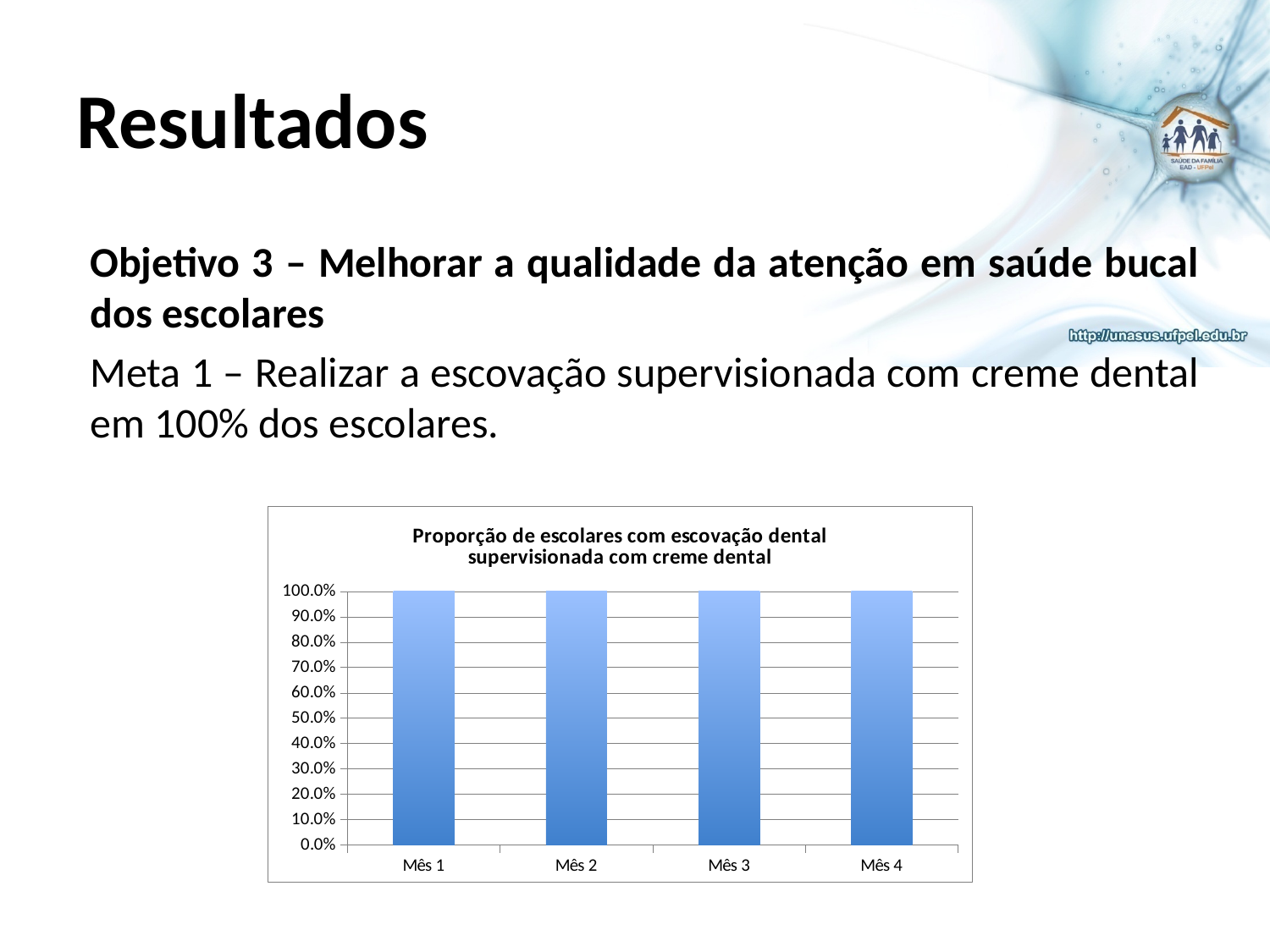
What is the label of the first category on the x axis? Mês 1 What is the value for Mês 3? 100.0% What is the highest value shown on the y axis? 100.0% What is the difference between the values for Mês 1 and Mês 4? 0.0% Do the values rise, fall or stay the same from Mês 1 to Mês 4? stay the same What is the value for Mês 1? 100.0% What is the value for Mês 4? 100.0% What is the title of the chart? Proporção de escolares com escovação dental supervisionada com creme dental What kind of chart is shown on the slide? bar chart How many categories are shown on the x axis of the chart? 4 Is the value for Mês 2 greater or less than 50.0%? greater